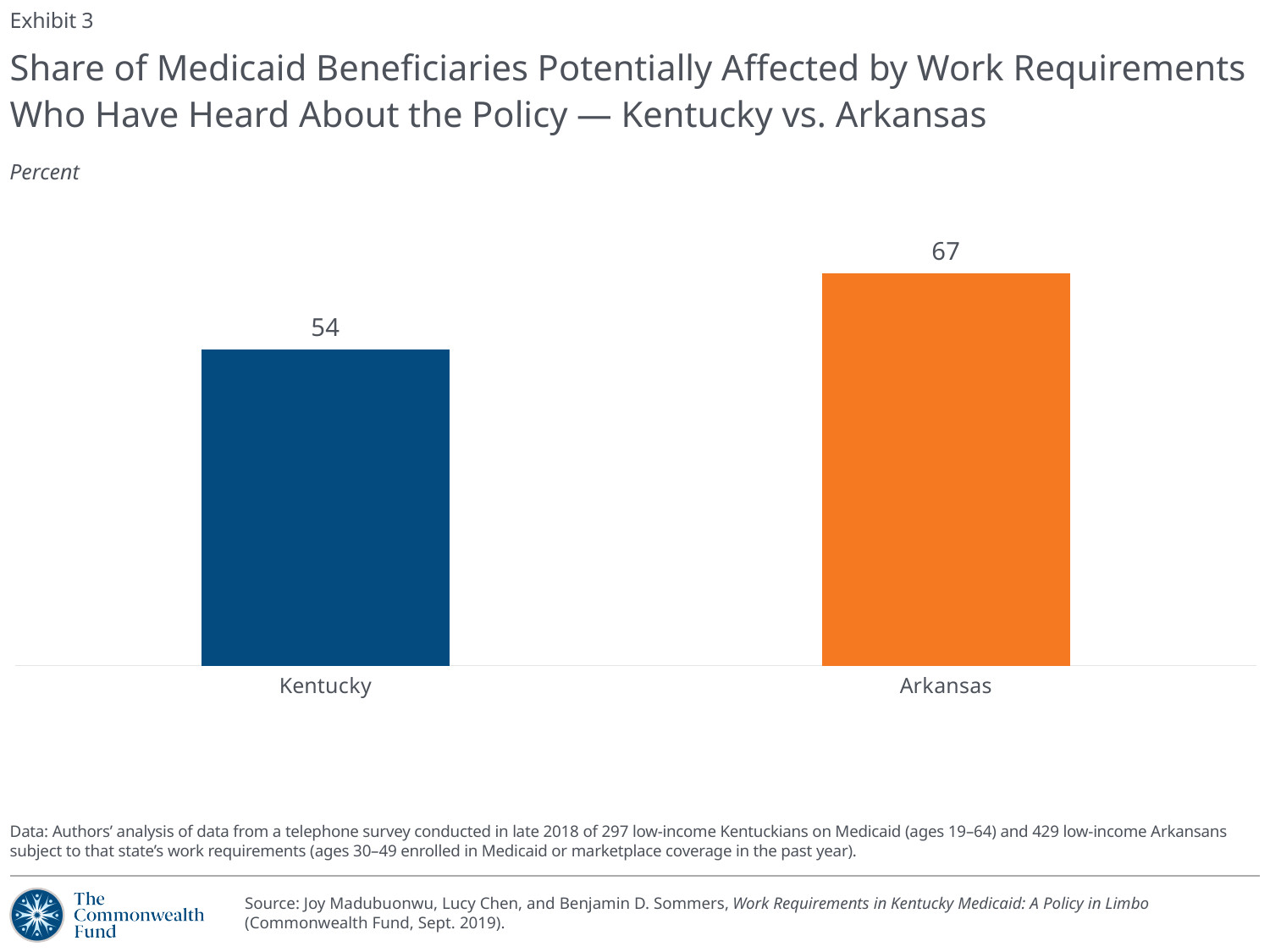
How many categories are shown in the chart? 2 Which state has the higher share of beneficiaries who have heard about the policy? Arkansas Which state has the lower share of beneficiaries who have heard about the policy? Kentucky What unit are the values in, according to the axis label under the title? Percent What colour is the bar for Arkansas? orange Is the value for Kentucky larger or smaller than the value for Arkansas? smaller What is the value for Kentucky? 54 What kind of chart is shown on the slide? bar chart What is the difference between the values for Arkansas and Kentucky? 13 What is the value for Arkansas? 67